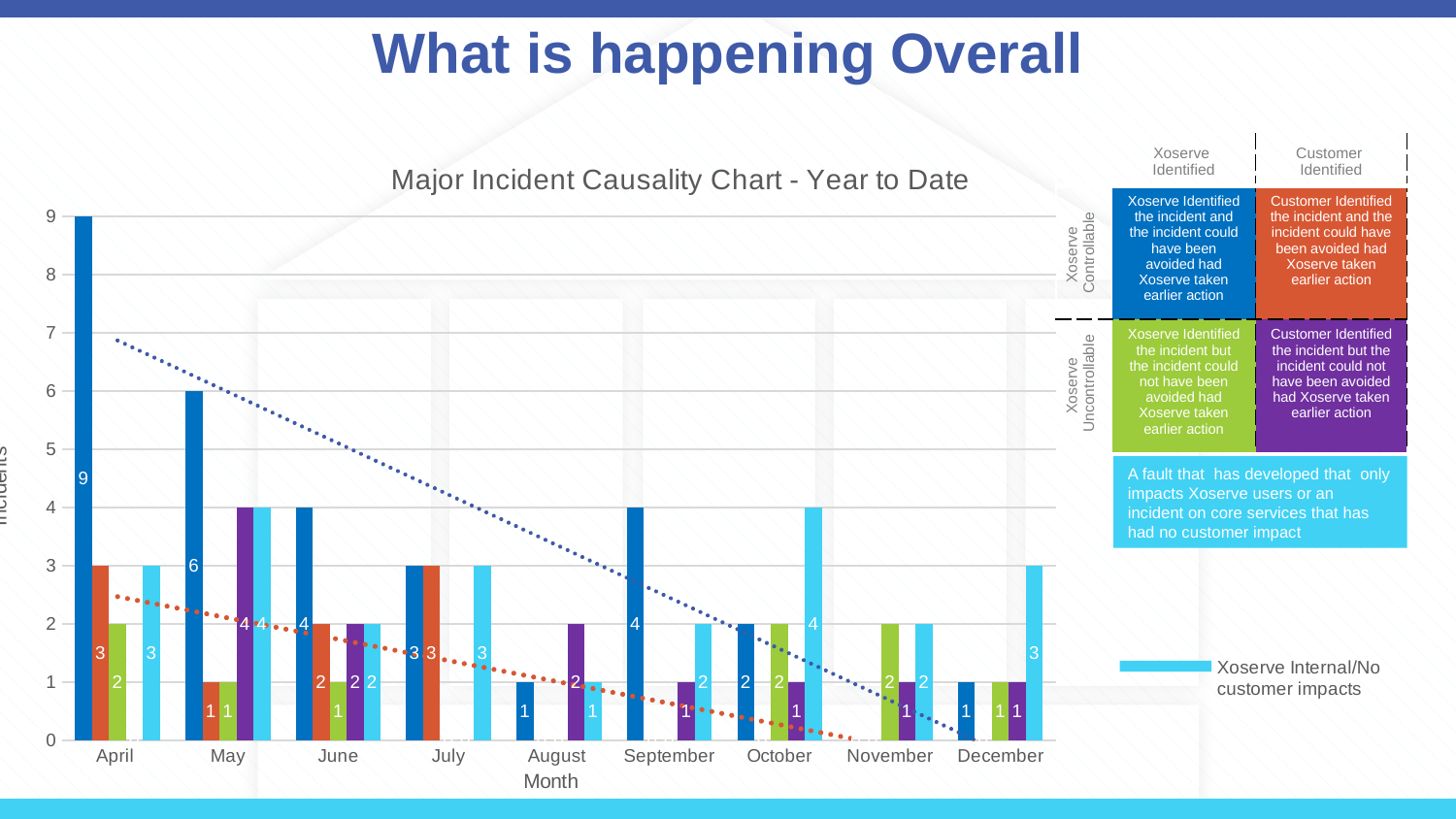
In the Major Incident Causality Chart, what is the value of the dark blue bar for April? 9 What kind of chart is the Major Incident Causality Chart? Bar chart In the Major Incident Causality Chart, what is the value of the light blue (Xoserve Internal/No customer impacts) bar for December? 3 In the Major Incident Causality Chart, which month has the larger light blue (Xoserve Internal/No customer impacts) bar, May or June? May In the Major Incident Causality Chart, what is the difference between the dark blue bar for April and the dark blue bar for May? 3 In the Major Incident Causality Chart, what is the value of the light blue (Xoserve Internal/No customer impacts) bar for October? 4 How many months are shown on the x axis of the Major Incident Causality Chart? 9 In the Major Incident Causality Chart, what is the value of the purple bar for May? 4 In the Major Incident Causality Chart, which month has the highest dark blue bar? April What is the title of the chart on the slide? Major Incident Causality Chart - Year to Date In the Major Incident Causality Chart, does the dark blue dotted trend line rise or fall from April to December? Fall According to the legend, what does the light blue bar in the Major Incident Causality Chart represent? Xoserve Internal/No customer impacts